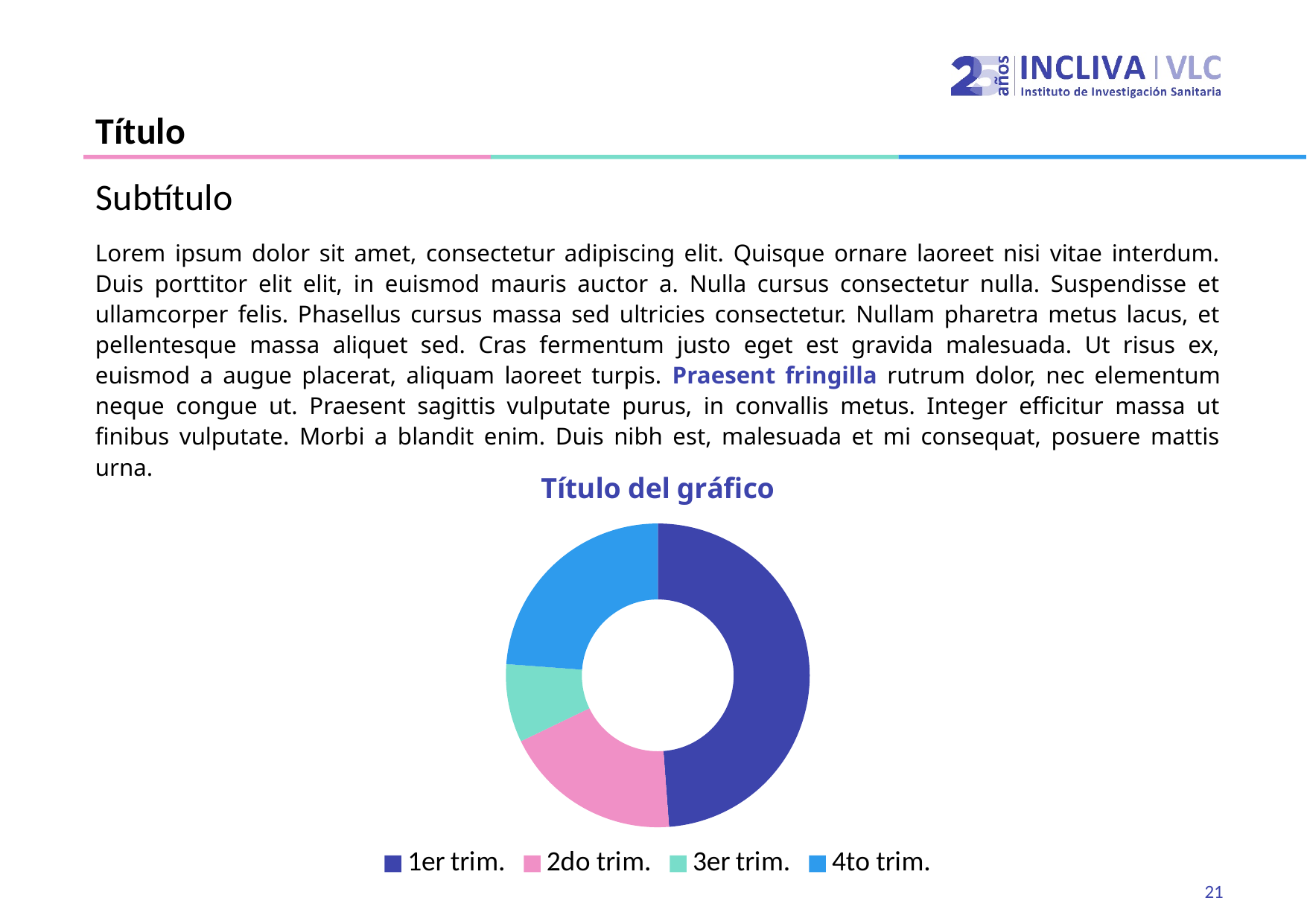
Which category has the smallest slice in the chart? 3er trim. Which slice is larger, 2do trim. or 3er trim.? 2do trim. Which category has the largest slice in the chart? 1er trim. How many categories does the chart's legend list? 4 What colour represents 2do trim. in the chart? Pink What is the title of the chart? Título del gráfico Which slice is larger, 1er trim. or 2do trim.? 1er trim. What kind of chart is shown on the slide? Doughnut chart Which slice is larger, 1er trim. or 4to trim.? 1er trim.